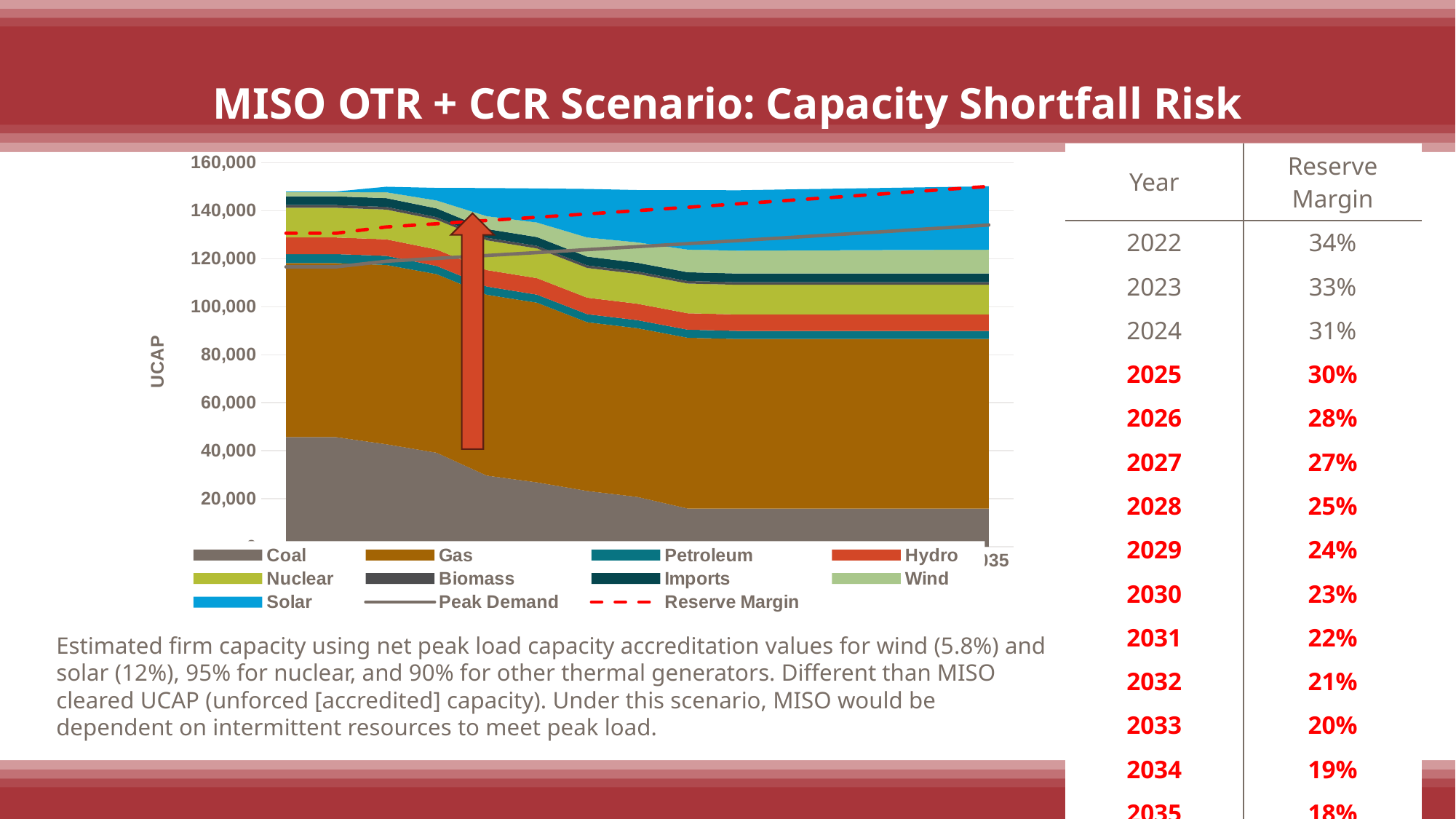
How many series does the chart's legend list? 11 What kind of chart is shown on the slide? Area chart Which series occupies the largest area in the stacked chart? Gas Is the Coal value at 2035 greater or less than 20,000? less Is the Coal value at the left end of the chart greater or less than 40,000? greater Is the Peak Demand value at 2035 greater or less than 120,000? greater Does the Coal area rise or fall from the left to the right of the chart? Fall What is the label on the chart's vertical axis? UCAP What is the highest value shown on the chart's vertical axis? 160,000 Which series is drawn as a red dashed line in the chart? Reserve Margin Does the Peak Demand line rise or fall across the chart? Rise